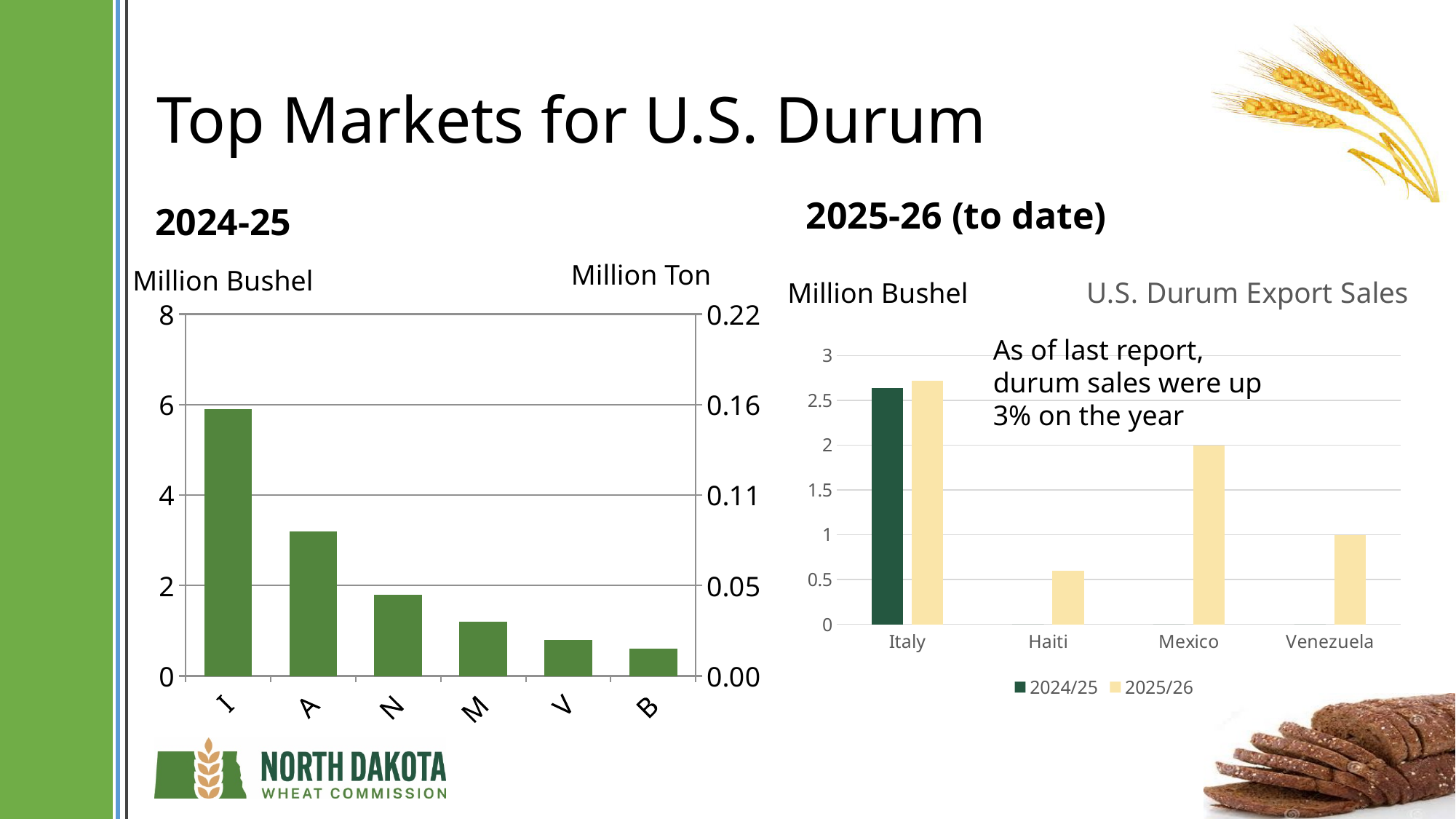
On the U.S. Durum Export Sales chart on the right, how many series does the legend list? 2 On the 2024-25 chart on the left, which category has the highest value? I On the U.S. Durum Export Sales chart on the right, is the 2025/26 value for Haiti greater or less than 1 million bushels? less On the 2024-25 chart on the left, is the value for N greater or less than 2 million bushels? less On the 2024-25 chart on the left, which category has the lowest value? B What kind of chart is the 2024-25 chart on the left? bar chart On the 2024-25 chart on the left, do the values rise or fall from left to right along the x axis? fall How many categories are shown on the 2024-25 chart on the left? 6 On the U.S. Durum Export Sales chart on the right, which country has the lowest 2025/26 value? Haiti On the U.S. Durum Export Sales chart on the right, how many countries are shown on the x axis? 4 On the 2024-25 chart on the left, is the value for I greater or less than 4 million bushels? greater On the U.S. Durum Export Sales chart on the right, which country has the highest 2025/26 value? Italy